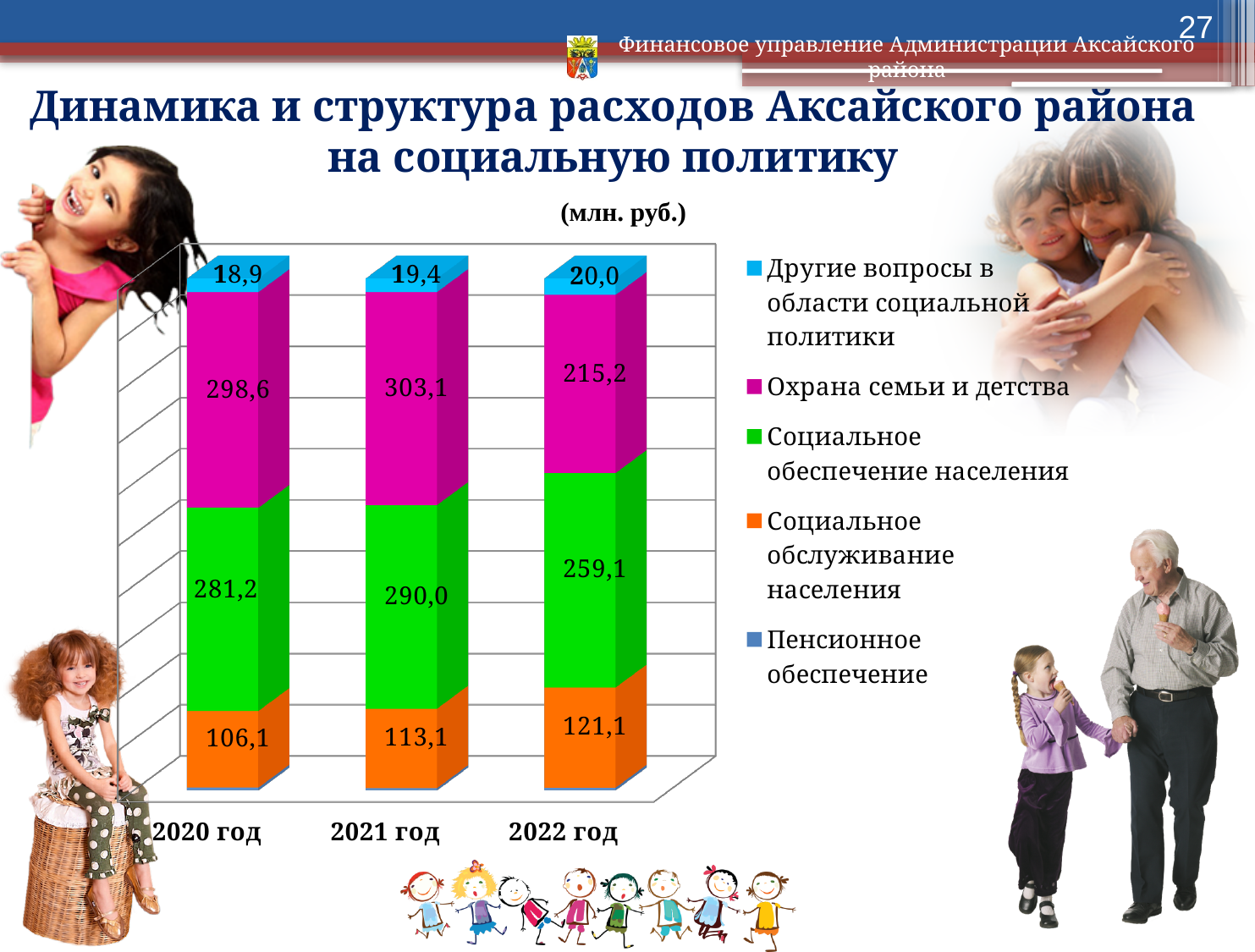
How many series does the legend list? 5 Do the values for Социальное обслуживание населения rise or fall from 2020 год to 2022 год? rise What is the value for Социальное обслуживание населения in 2022 год? 121,1 How many years (categories) are shown on the x axis? 3 What is the value for Социальное обеспечение населения in 2021 год? 290,0 What is the value for Другие вопросы в области социальной политики in 2020 год? 18,9 What type of chart is shown on the slide? stacked bar chart In which year is the value for Социальное обслуживание населения the highest? 2022 год What is the difference between the Социальное обслуживание населения values for 2022 год and 2020 год? 15,0 What is the value for Охрана семьи и детства in 2021 год? 303,1 In which year is the value for Охрана семьи и детства the lowest? 2022 год Which is larger in 2022 год: Социальное обеспечение населения or Охрана семьи и детства? Социальное обеспечение населения